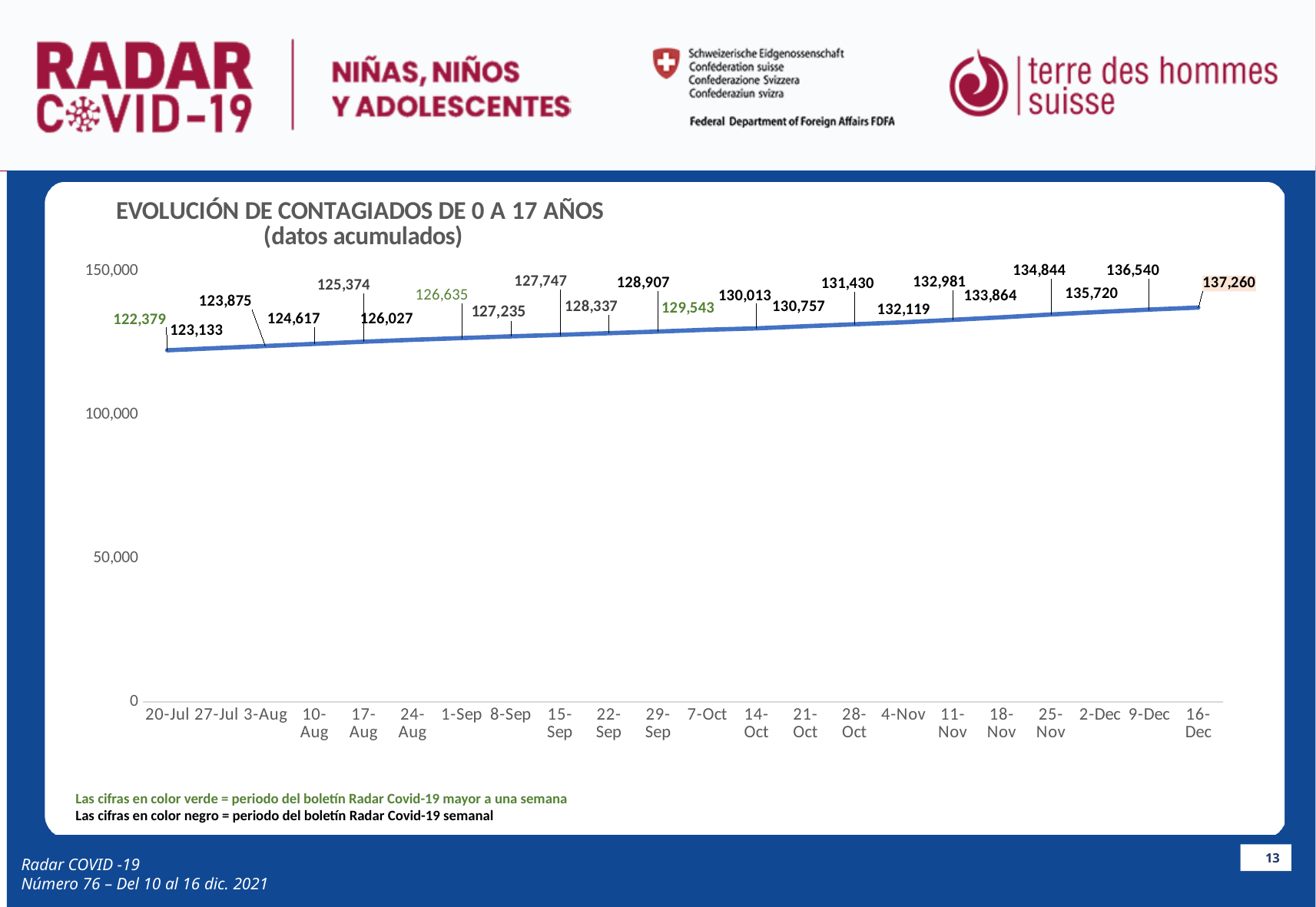
Is the value for 16-Dec greater or less than 100,000? greater Do the values rise or fall from 20-Jul to 16-Dec? rise What is the cumulative number of infected children aged 0 to 17 on 16-Dec? 137,260 What is the difference between the values for 16-Dec and 20-Jul? 14,881 Which is larger, the value for 25-Nov or the value for 11-Nov? 25-Nov What value is shown for 7-Oct? 129,543 How many dates are plotted on the x axis? 22 What value is shown for 20-Jul? 122,379 Which date has the lowest value on the chart? 20-Jul What kind of chart is shown on the slide? line chart What is the difference between the values for 16-Dec and 9-Dec? 720 Which date has the highest value on the chart? 16-Dec